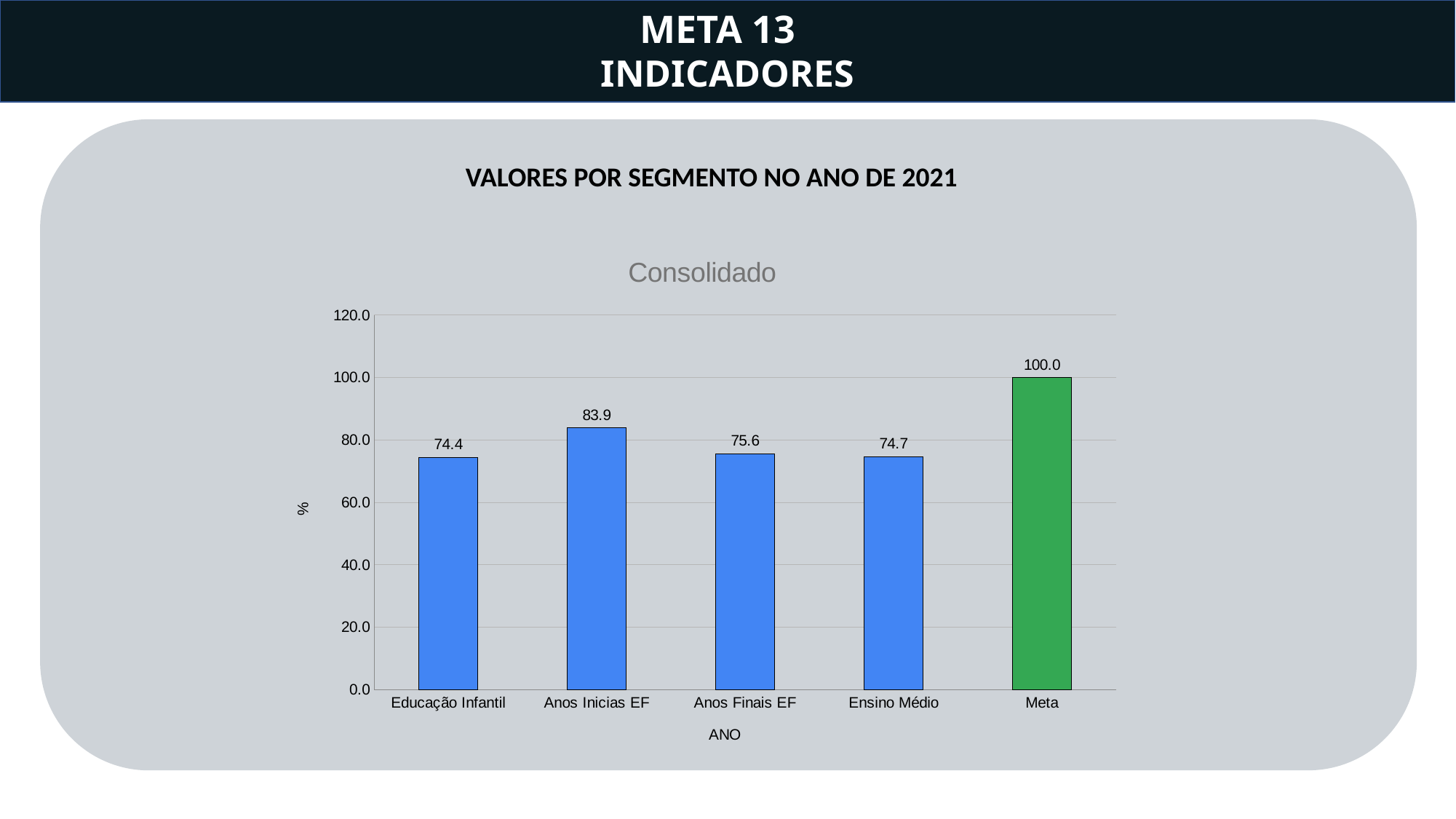
Which category has the highest value? Meta Which category has the lowest value? Educação Infantil What is the value for Meta? 100.0 How many categories are shown on the x axis? 5 What is the difference between the Meta value and the Anos Inicias EF value? 16.1 What is the value for Educação Infantil? 74.4 What is the value for Anos Inicias EF? 83.9 What kind of chart is shown? Bar chart Which is larger, the value for Anos Inicias EF or the value for Anos Finais EF? Anos Inicias EF What is the value for Ensino Médio? 74.7 What is the title of the chart? Consolidado What is the value for Anos Finais EF? 75.6